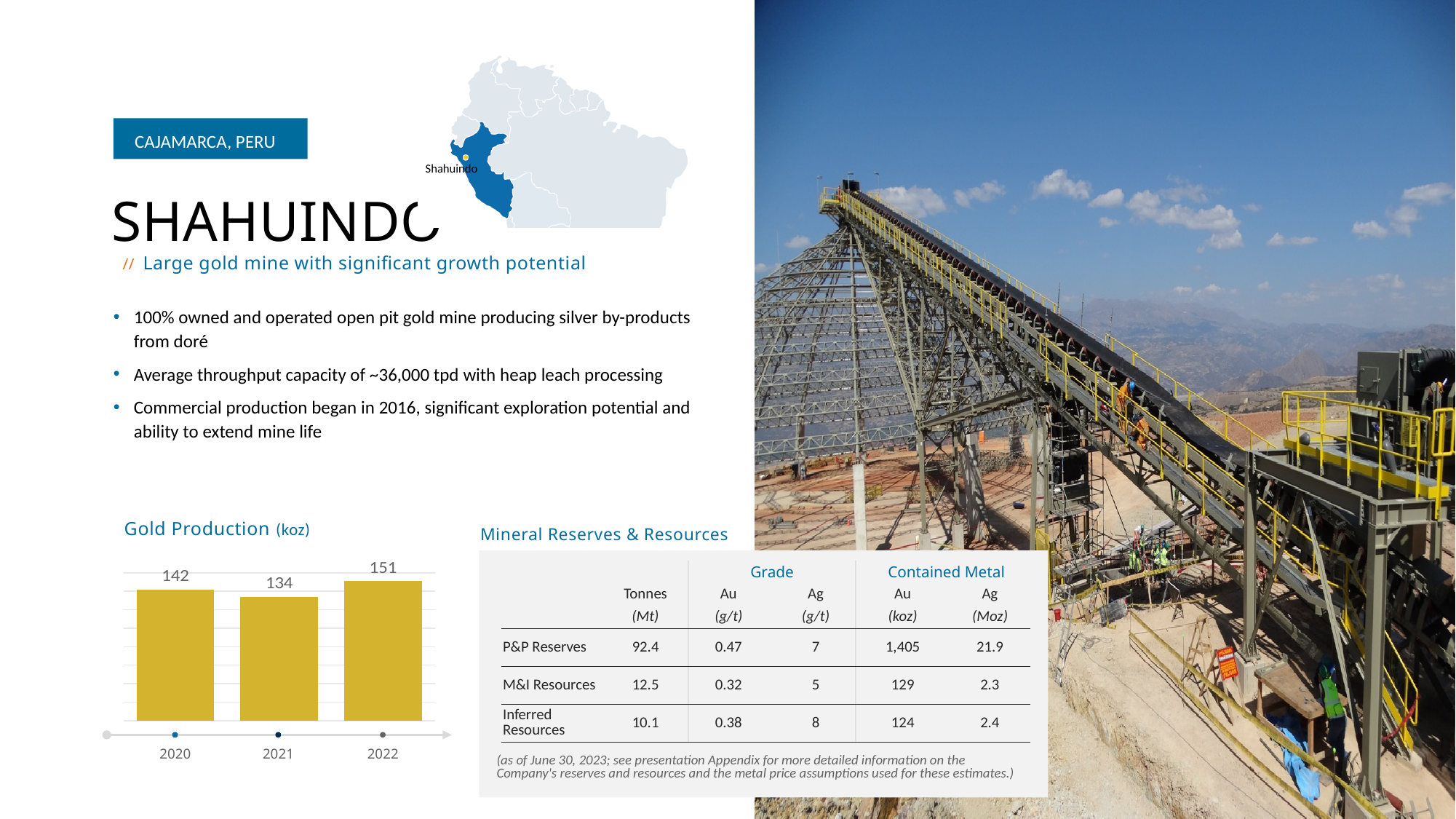
How many years are shown in the Gold Production chart? 3 In the Gold Production chart, is the value for 2020 or 2022 larger? 2022 Which year has the lowest gold production in the Gold Production chart? 2021 What colour are the bars in the Gold Production chart? Gold/yellow What kind of chart is the Gold Production chart? Bar chart What is the difference in gold production between 2020 and 2021 in the Gold Production chart? 8 What is the gold production value for 2020 in the Gold Production chart? 142 What is the gold production value for 2021 in the Gold Production chart? 134 Which year has the highest gold production in the Gold Production chart? 2022 What is the gold production value for 2022 in the Gold Production chart? 151 What is the difference in gold production between 2022 and 2021 in the Gold Production chart? 17 What unit is gold production measured in, according to the Gold Production chart title? koz